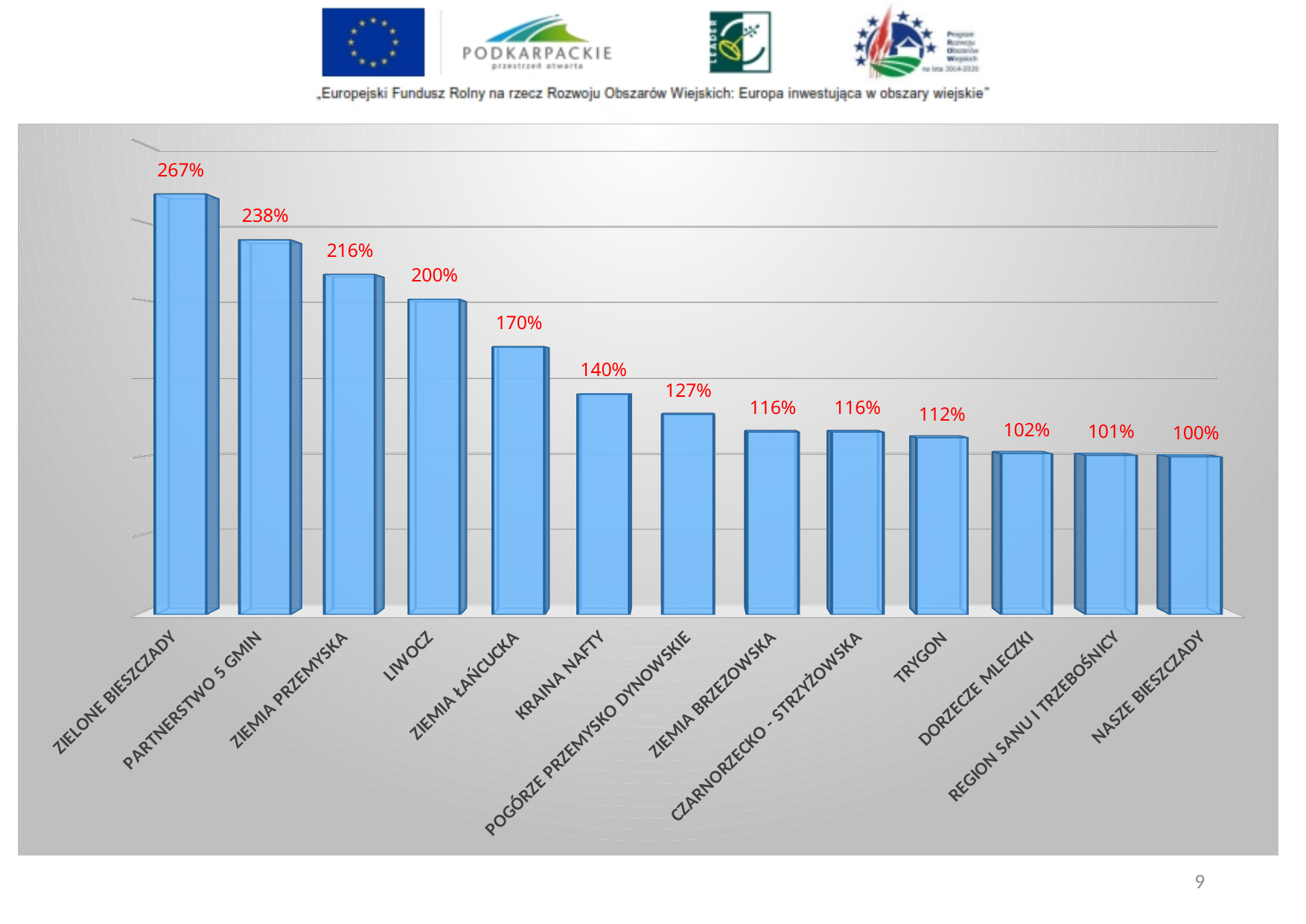
What is the difference between the values for ZIEMIA ŁAŃCUCKA and POGÓRZE PRZEMYSKO DYNOWSKIE? 43% Do the values rise or fall from left to right along the x axis? Fall What is the value for KRAINA NAFTY? 140% Which is larger, the value for ZIEMIA PRZEMYSKA or the value for DORZECZE MLECZKI? ZIEMIA PRZEMYSKA What kind of chart is shown on the slide? Bar chart What is the value for TRYGON? 112% What is the value for REGION SANU I TRZEBOŚNICY? 101% Which category has the highest value? ZIELONE BIESZCZADY What is the value for ZIELONE BIESZCZADY? 267% Which category has the lowest value? NASZE BIESZCZADY How many categories are shown on the chart? 13 What is the difference between the values for PARTNERSTWO 5 GMIN and LIWOCZ? 38%